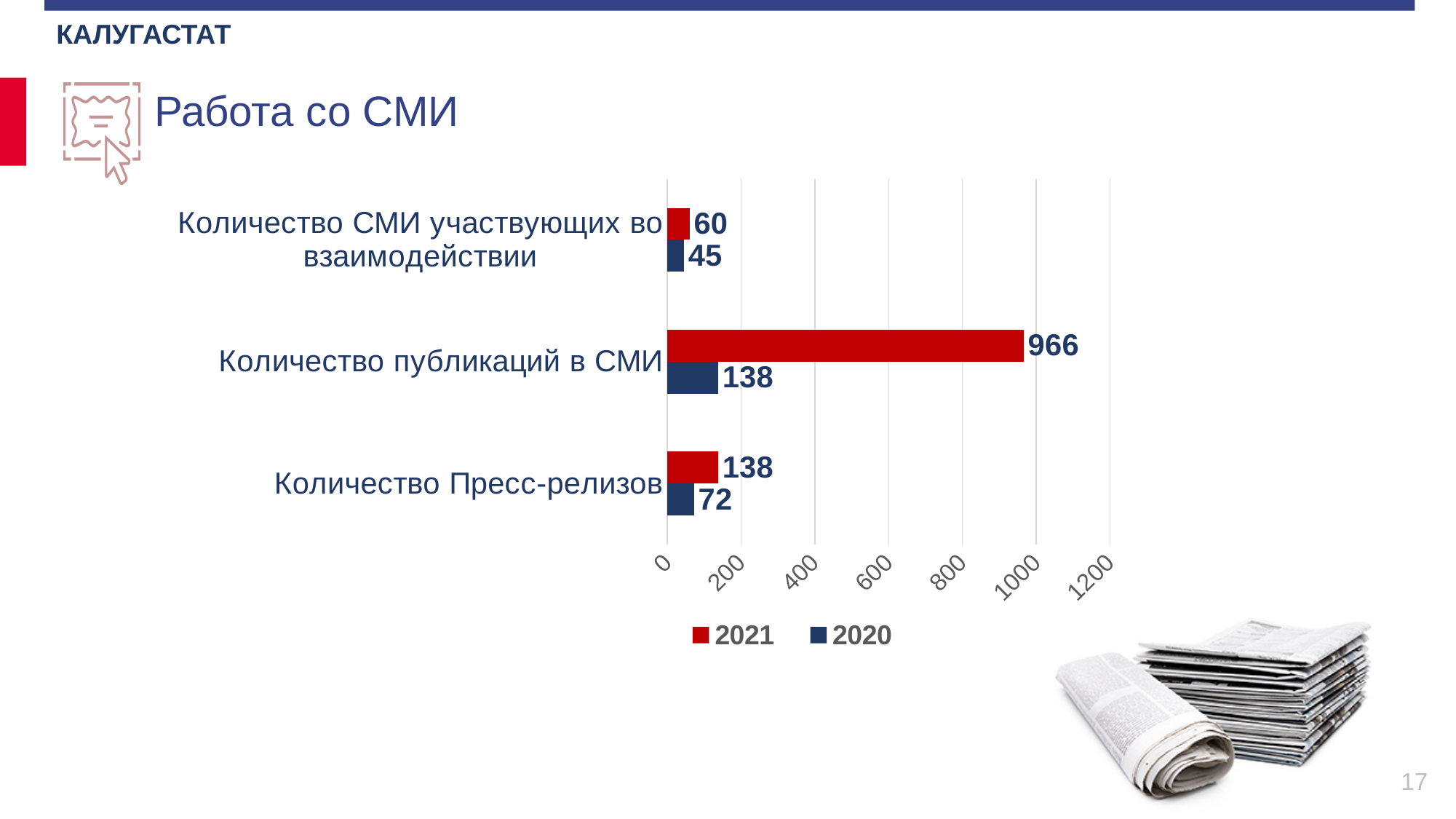
Which is larger: the 2021 value for Количество Пресс-релизов or the 2021 value for Количество СМИ участвующих во взаимодействии? Количество Пресс-релизов Which category has the lowest value for 2020? Количество СМИ участвующих во взаимодействии Which category has the highest value for 2021? Количество публикаций в СМИ How many categories are shown on the chart? 3 How many series does the legend list? 2 What kind of chart is shown on the slide? Bar chart What is the value for 2020 for Количество Пресс-релизов? 72 What is the value for 2021 for Количество СМИ участвующих во взаимодействии? 60 What is the value for 2020 for Количество публикаций в СМИ? 138 What is the value for 2021 for Количество публикаций в СМИ? 966 What is the difference between the 2021 and 2020 values for Количество Пресс-релизов? 66 What is the difference between the 2021 and 2020 values for Количество публикаций в СМИ? 828